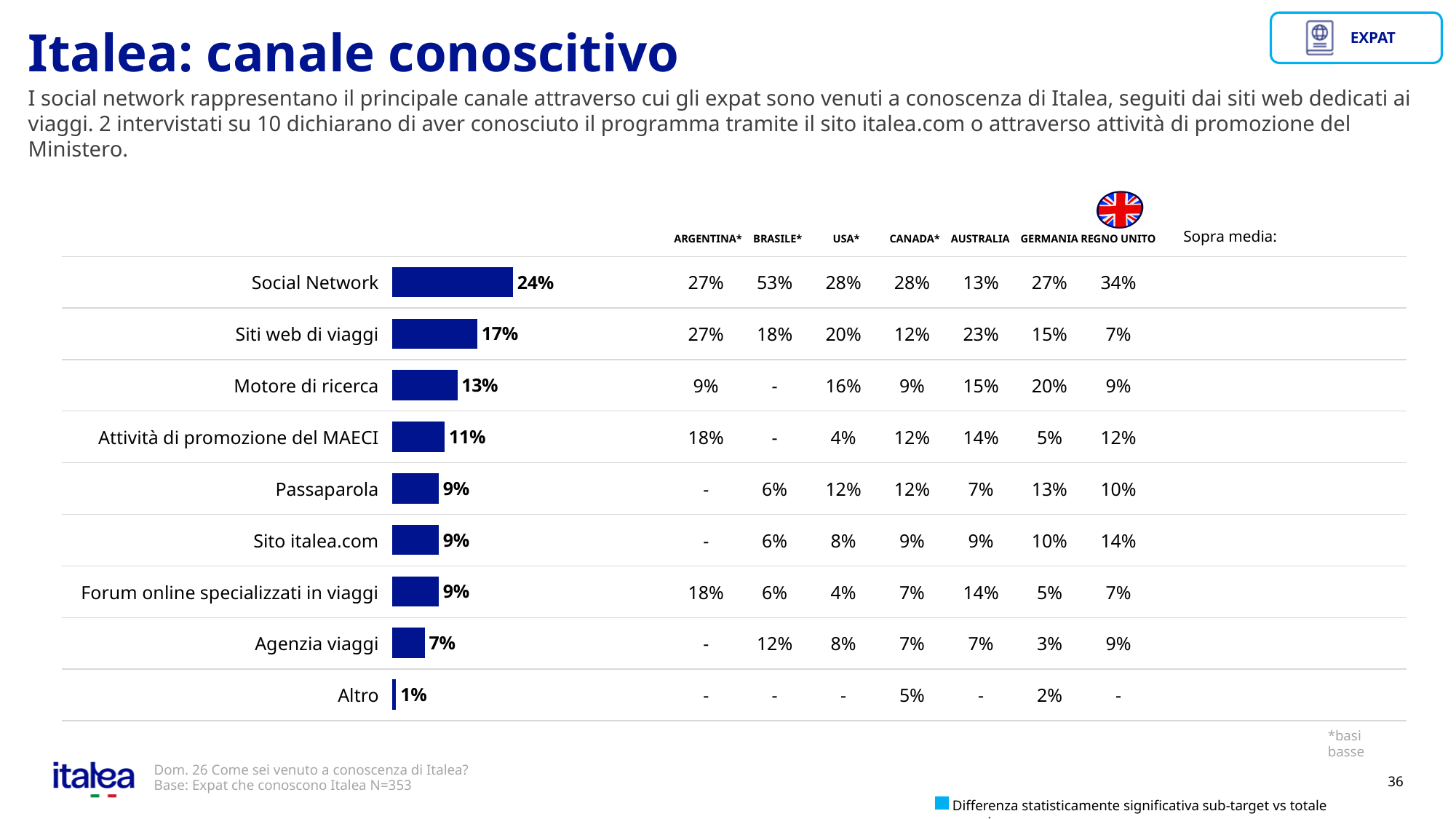
What is the value shown for Agenzia viaggi in the bar chart? 7% What is the value shown for Siti web di viaggi in the bar chart? 17% What is the value shown for Attività di promozione del MAECI in the bar chart? 11% How many categories in the bar chart have a value of 9%? 3 What is the difference between the values for Motore di ricerca and Agenzia viaggi? 6% How many categories are shown in the bar chart? 9 What is the value shown for Social Network in the bar chart? 24% Which category has the lowest value in the bar chart? Altro Which category has the highest value in the bar chart? Social Network Which is larger in the bar chart: Motore di ricerca or Attività di promozione del MAECI? Motore di ricerca What kind of chart is shown on the slide? Bar chart What is the difference between the values for Social Network and Siti web di viaggi? 7%